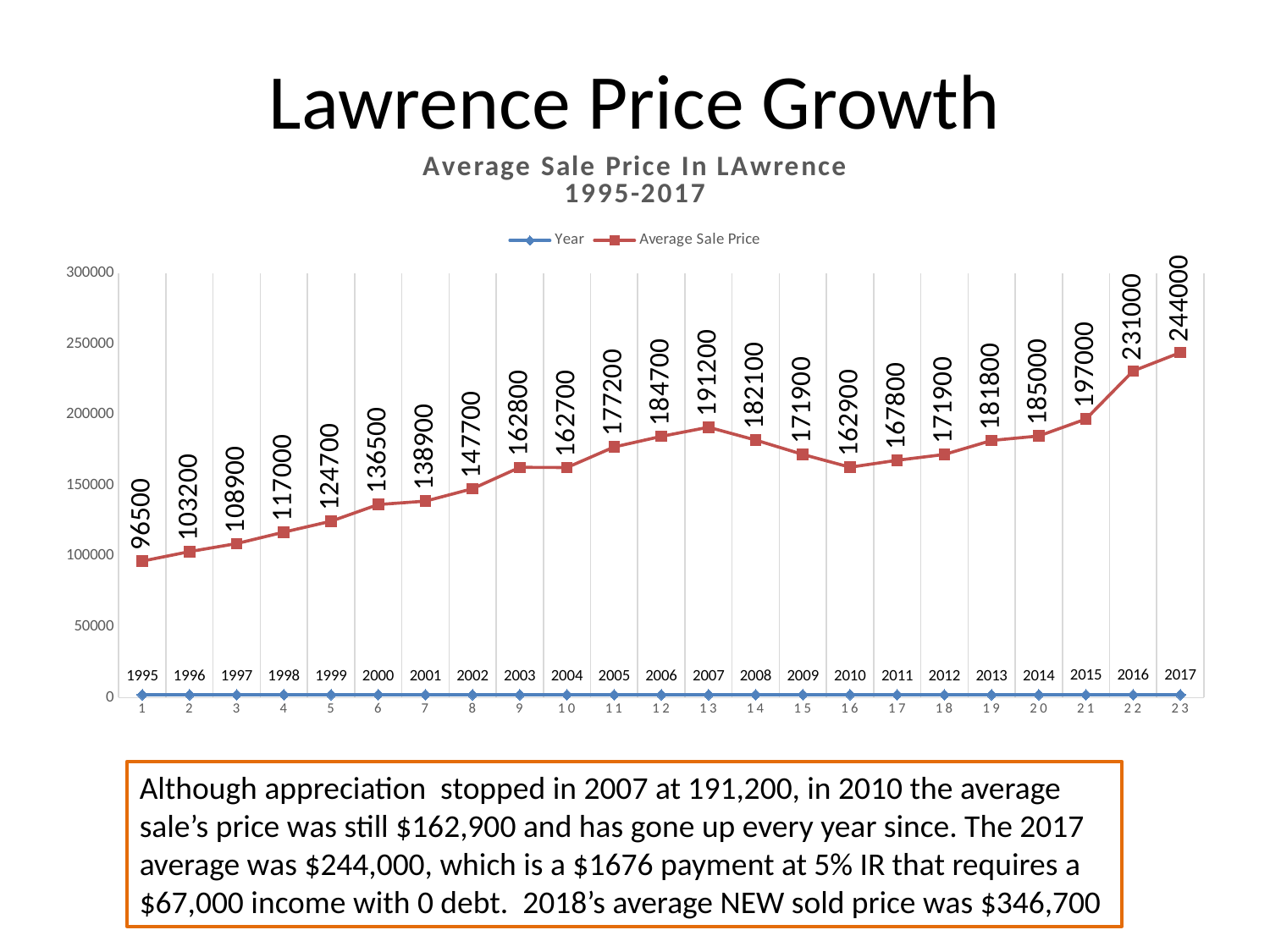
What is the average sale price for 2007? 191200 What is the difference between the average sale price in 2017 and in 2016? 13000 Which year has the lowest average sale price? 1995 Which year has a higher average sale price, 2008 or 2012? 2008 What is the average sale price for 2010? 162900 What is the difference between the average sale price in 2007 and in 2010? 28300 Is the average sale price for 2015 greater or less than 200000? less How many series does the legend list? 2 What is the average sale price for 1995? 96500 What kind of chart is shown on the slide? line chart How many years are plotted on the chart? 23 Which year has the highest average sale price? 2017